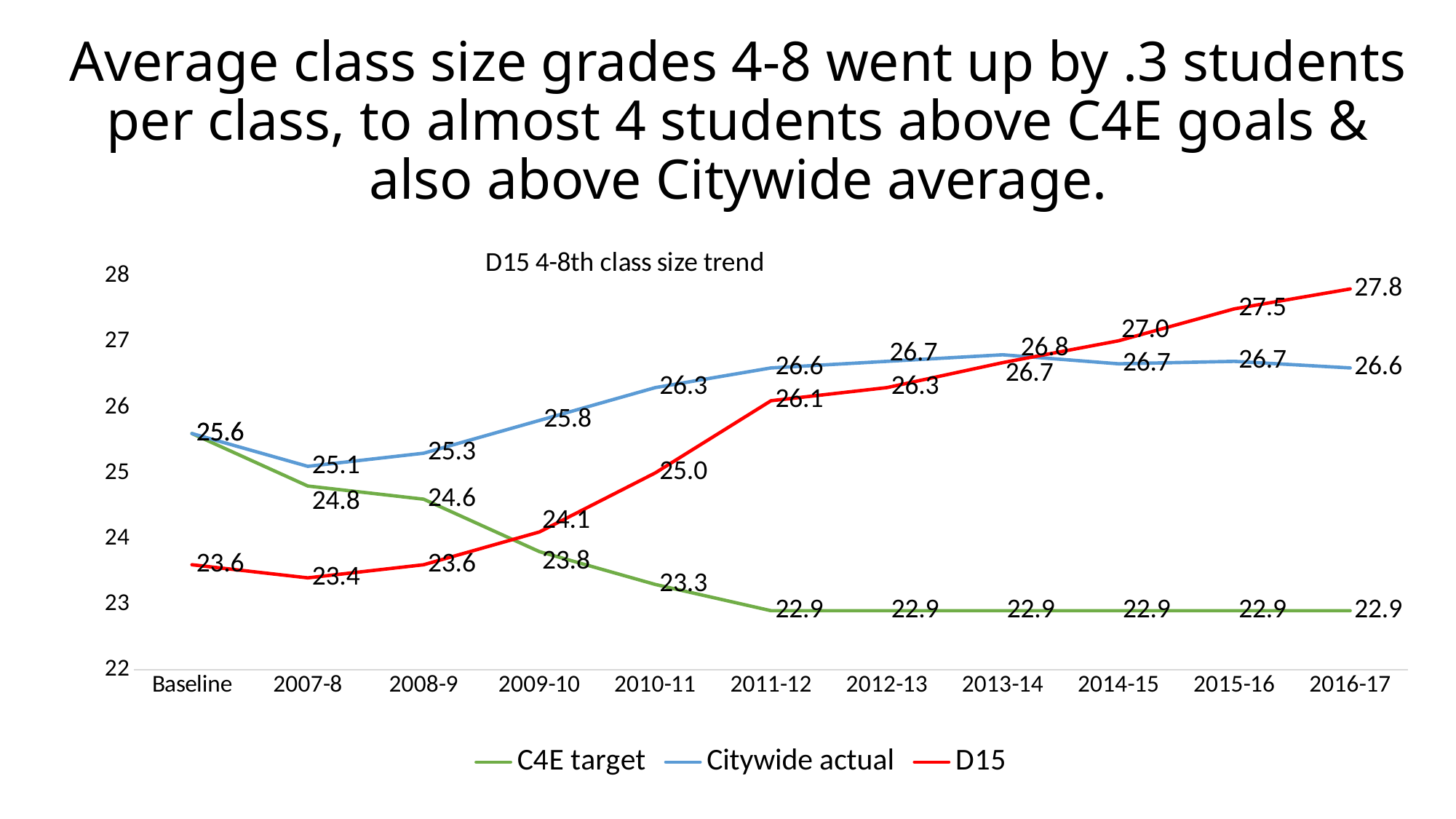
What is the Citywide actual value for 2013-14? 26.8 What is the D15 value for 2016-17? 27.8 In which year is the D15 value highest? 2016-17 By how much did the D15 value change from 2015-16 to 2016-17? 0.3 In 2016-17, which is larger: the D15 value or the Citywide actual value? D15 What is the difference between the D15 value and the C4E target value in 2016-17? 4.9 In which year is the D15 value lowest? 2007-8 What is the C4E target value for 2010-11? 23.3 What is the D15 value for 2009-10? 24.1 What kind of chart is shown on the slide? Line chart How many series does the legend list? 3 How many points are plotted along the x axis for each series? 11